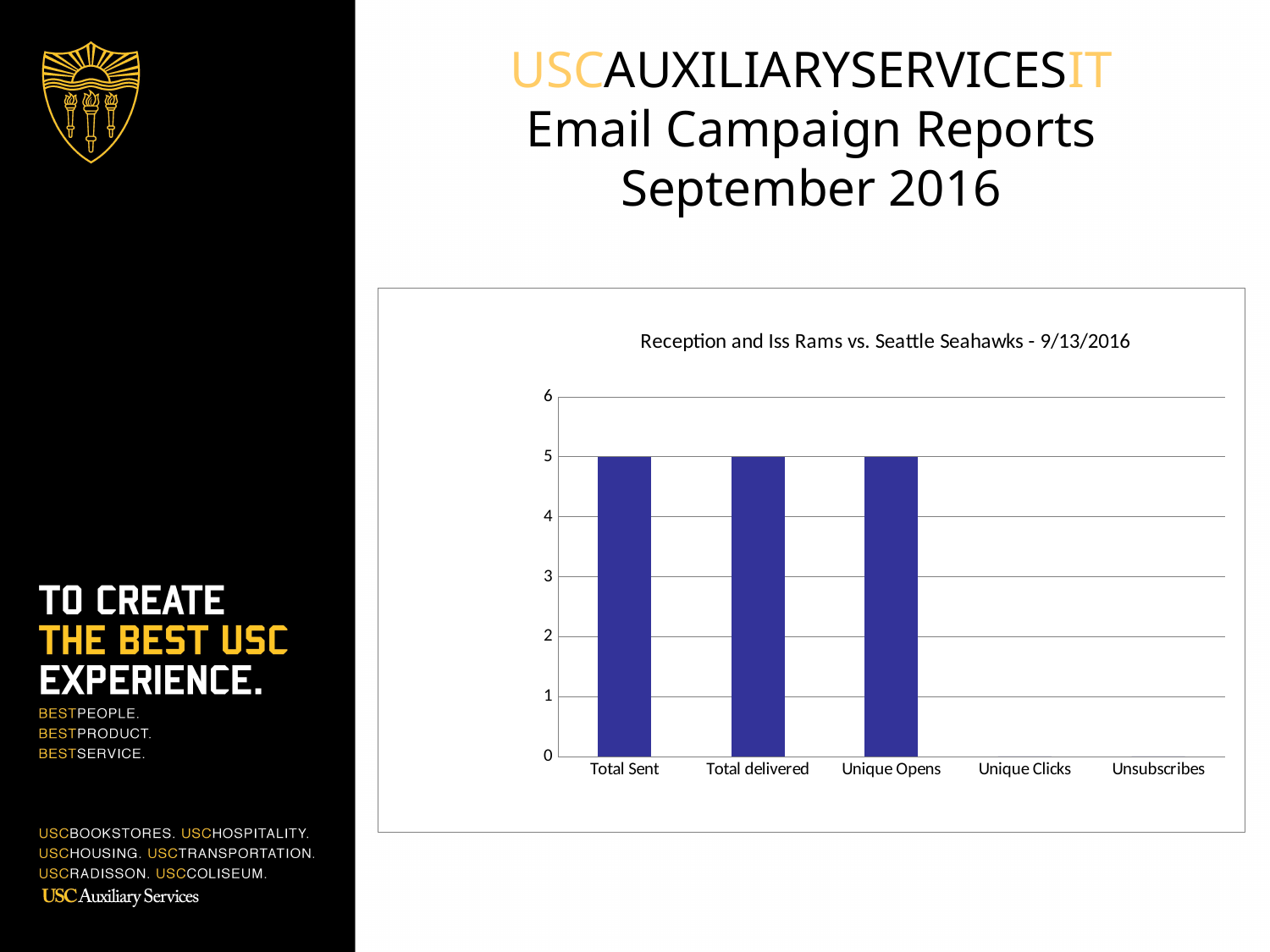
What is the value for Unique Opens? 5 What is the value for Total delivered? 5 Do the values rise or fall moving from Total Sent to Unsubscribes along the x axis? fall What is the title of the chart? Reception and Iss Rams vs. Seattle Seahawks - 9/13/2016 What is the value for Total Sent? 5 What is the highest value shown on the vertical axis? 6 What is the value for Unique Clicks? 0 Which is larger, the value for Total Sent or the value for Unique Clicks? Total Sent Is the value for Total delivered greater or less than 3? greater What kind of chart is shown on the slide? bar chart How many categories are shown on the x axis? 5 What is the difference between the value for Total Sent and the value for Unsubscribes? 5